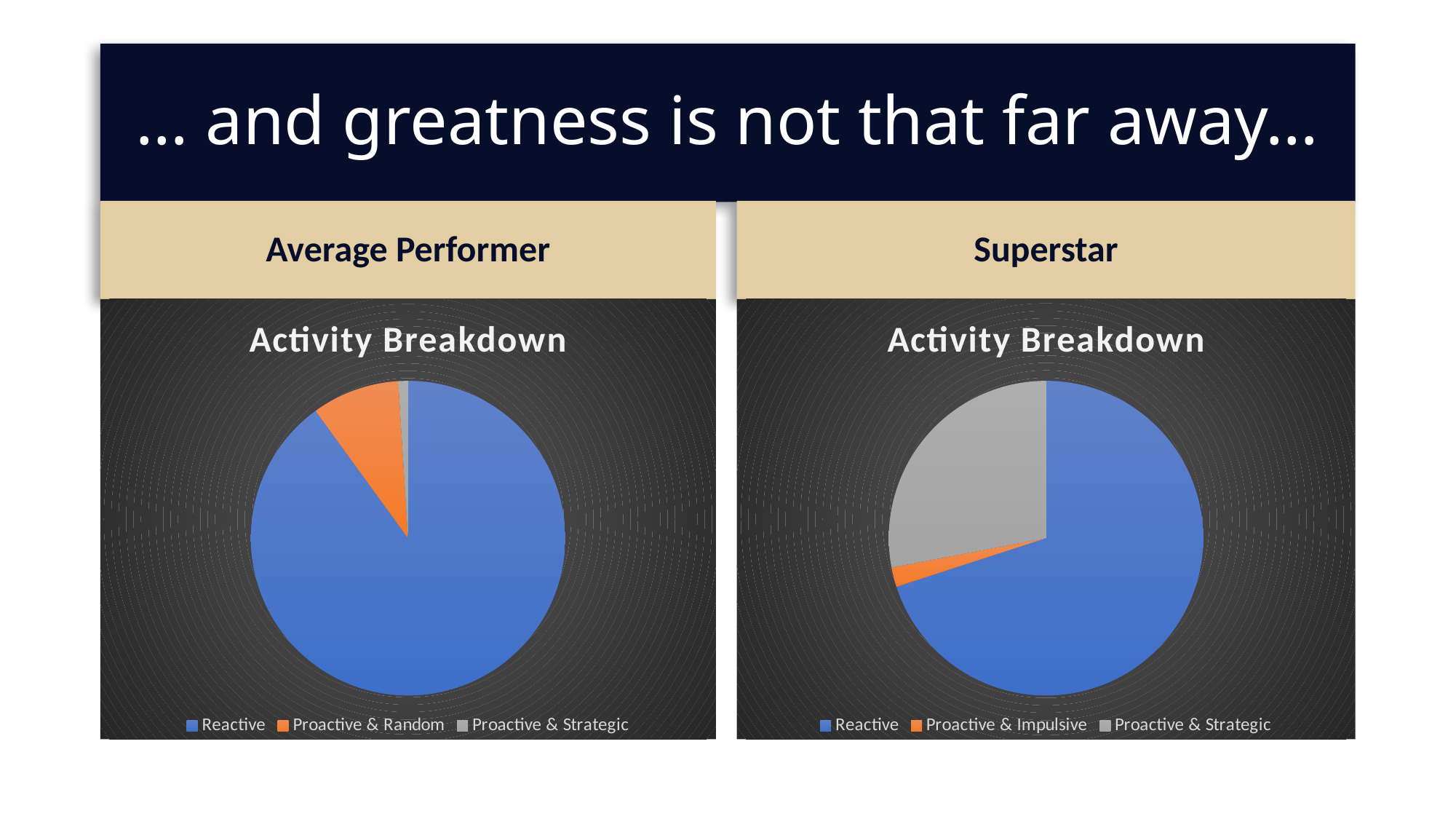
In the Superstar pie chart, which slice is larger: Proactive & Strategic or Proactive & Impulsive? Proactive & Strategic What kind of chart is shown under the Superstar heading? Pie chart In the Average Performer pie chart, which slice is larger: Proactive & Random or Proactive & Strategic? Proactive & Random What is the title of the pie chart under the Superstar heading? Activity Breakdown In the Superstar pie chart, which category is shown in grey? Proactive & Strategic In the Average Performer pie chart, which category has the smallest slice? Proactive & Strategic In the Superstar pie chart, which category has the largest slice? Reactive How many categories does the legend of the Average Performer pie chart list? 3 How many slices does the Superstar pie chart have? 3 In the Superstar pie chart, which category has the smallest slice? Proactive & Impulsive What kind of chart is shown under the Average Performer heading? Pie chart In the Average Performer pie chart, which category has the largest slice? Reactive